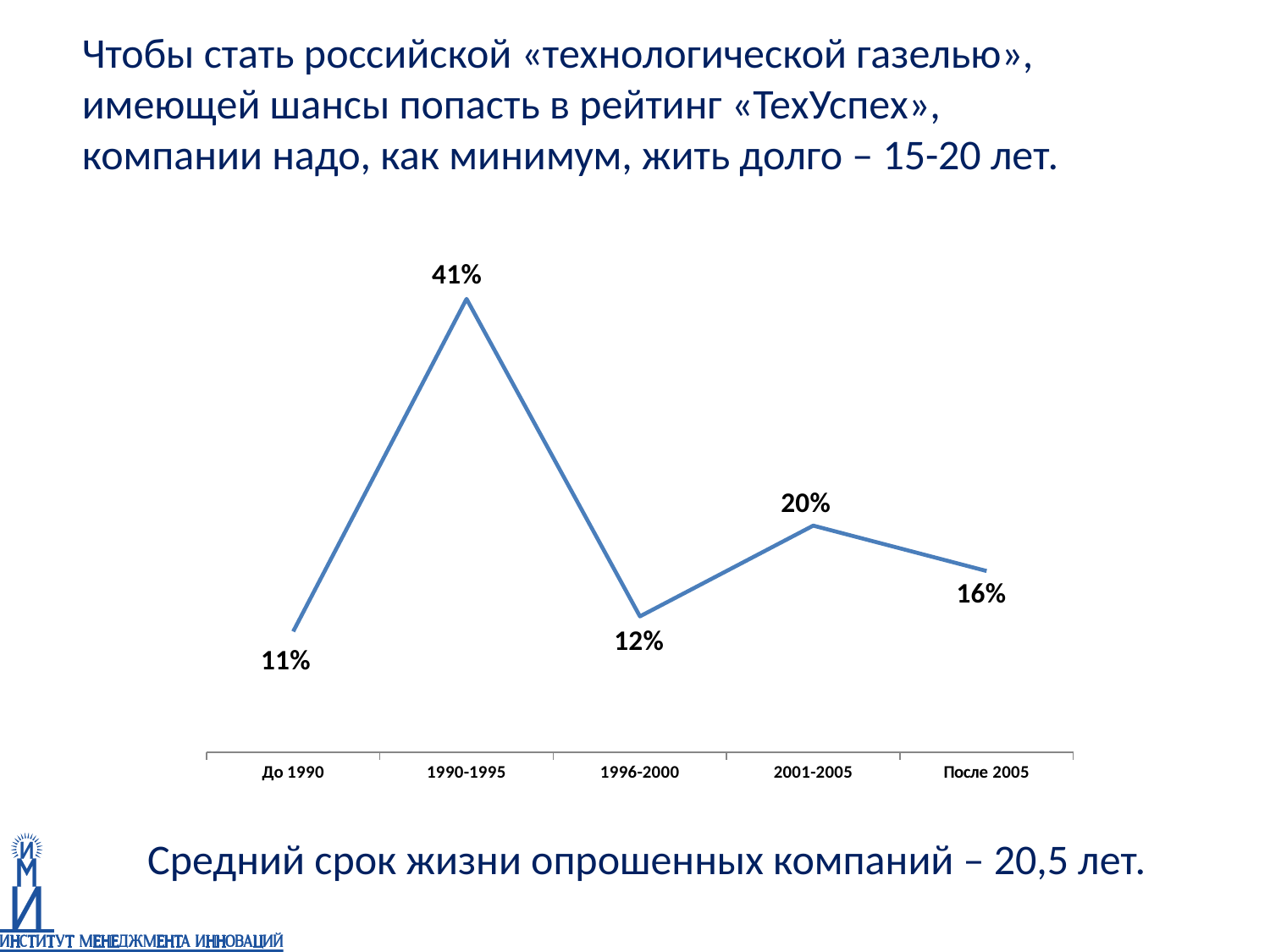
What is the value for 1990-1995? 41% What is the value for После 2005? 16% What is the difference between the values for 2001-2005 and До 1990? 9% Does the value rise or fall from 2001-2005 to После 2005? fall What is the difference between the values for 1990-1995 and 1996-2000? 29% How many categories are plotted on the x axis? 5 What type of chart is shown on the slide? line chart Which category has the highest value? 1990-1995 What is the value for До 1990? 11% Which is larger, the value for 2001-2005 or the value for После 2005? 2001-2005 Which category has the lowest value? До 1990 What is the value for 1996-2000? 12%